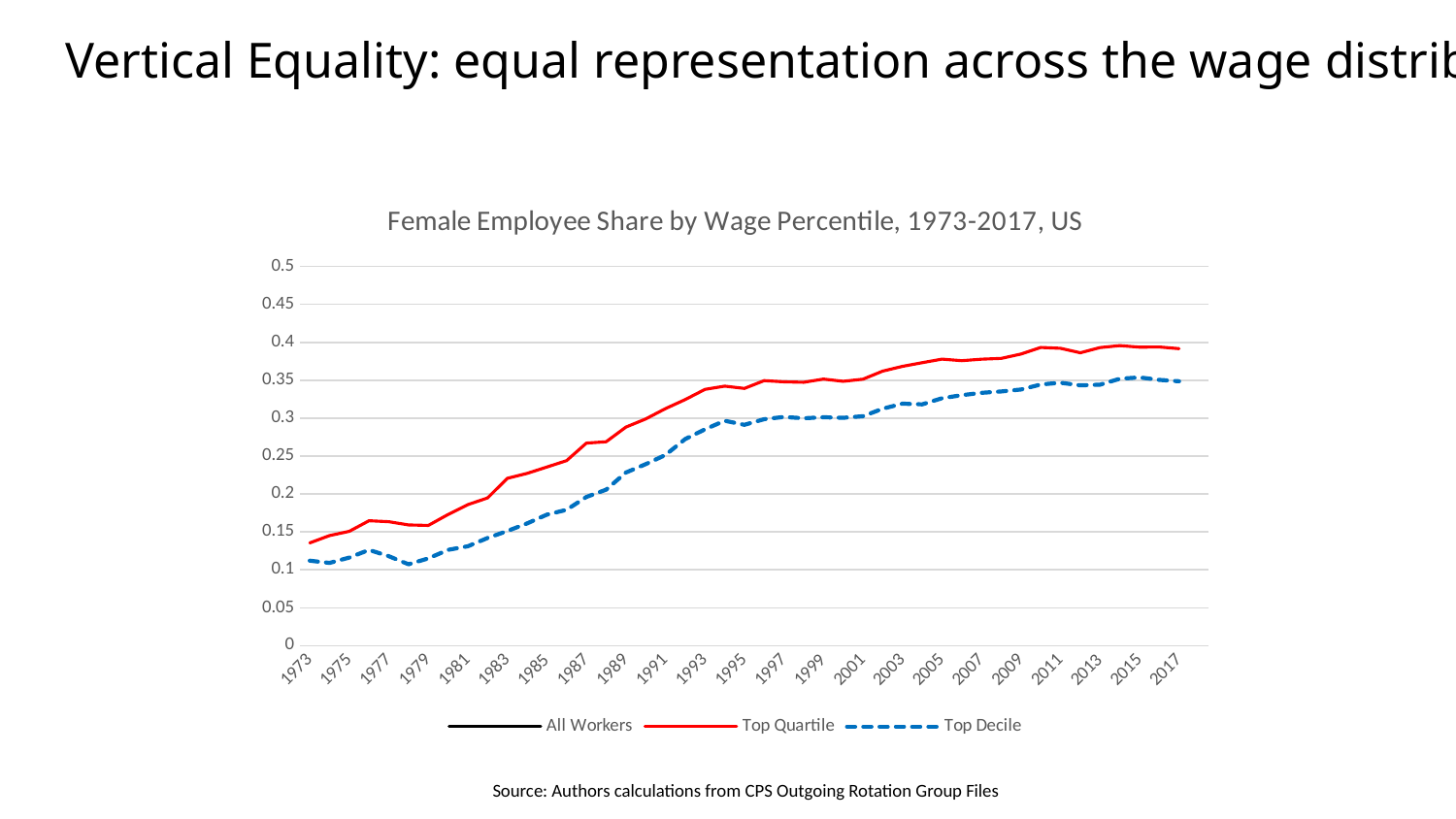
What is the title of the chart? Female Employee Share by Wage Percentile, 1973-2017, US Does the Top Decile series generally rise or fall from 1973 to 2017? rise What kind of chart is shown on the slide? line chart Is the Top Decile value in 1979 greater or less than 0.15? less Is the Top Quartile value in 1973 greater or less than 0.15? less How many series does the chart's legend list? 3 In 1995, which series has the larger value, Top Quartile or Top Decile? Top Quartile Is the Top Quartile value in 1983 greater or less than 0.2? greater Which series is drawn as a dashed blue line? Top Decile Does the Top Quartile series generally rise or fall from 1973 to 2017? rise